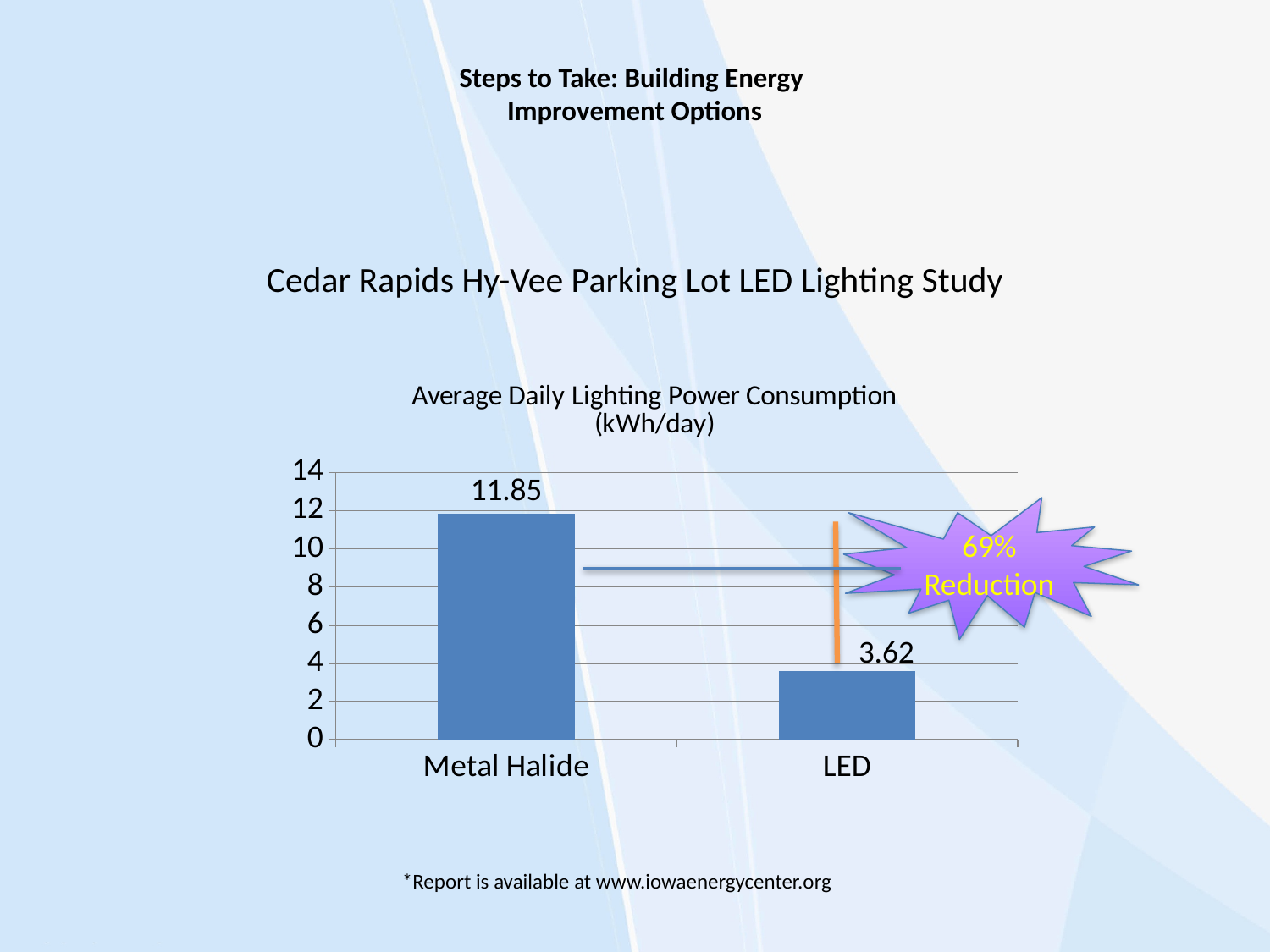
How many categories are shown in the chart? 2 Is the value for LED greater or less than 4? less What percentage reduction does the callout on the chart state? 69% Reduction What is the average daily lighting power consumption for Metal Halide? 11.85 Is the value for Metal Halide greater or less than 10? greater Which has a larger average daily lighting power consumption, Metal Halide or LED? Metal Halide What is the difference in average daily lighting power consumption between Metal Halide and LED? 8.23 What is the average daily lighting power consumption for LED? 3.62 What kind of chart is shown on the slide? bar chart What is the title of the chart? Average Daily Lighting Power Consumption (kWh/day) Which category has the highest average daily lighting power consumption? Metal Halide Which category has the lowest average daily lighting power consumption? LED